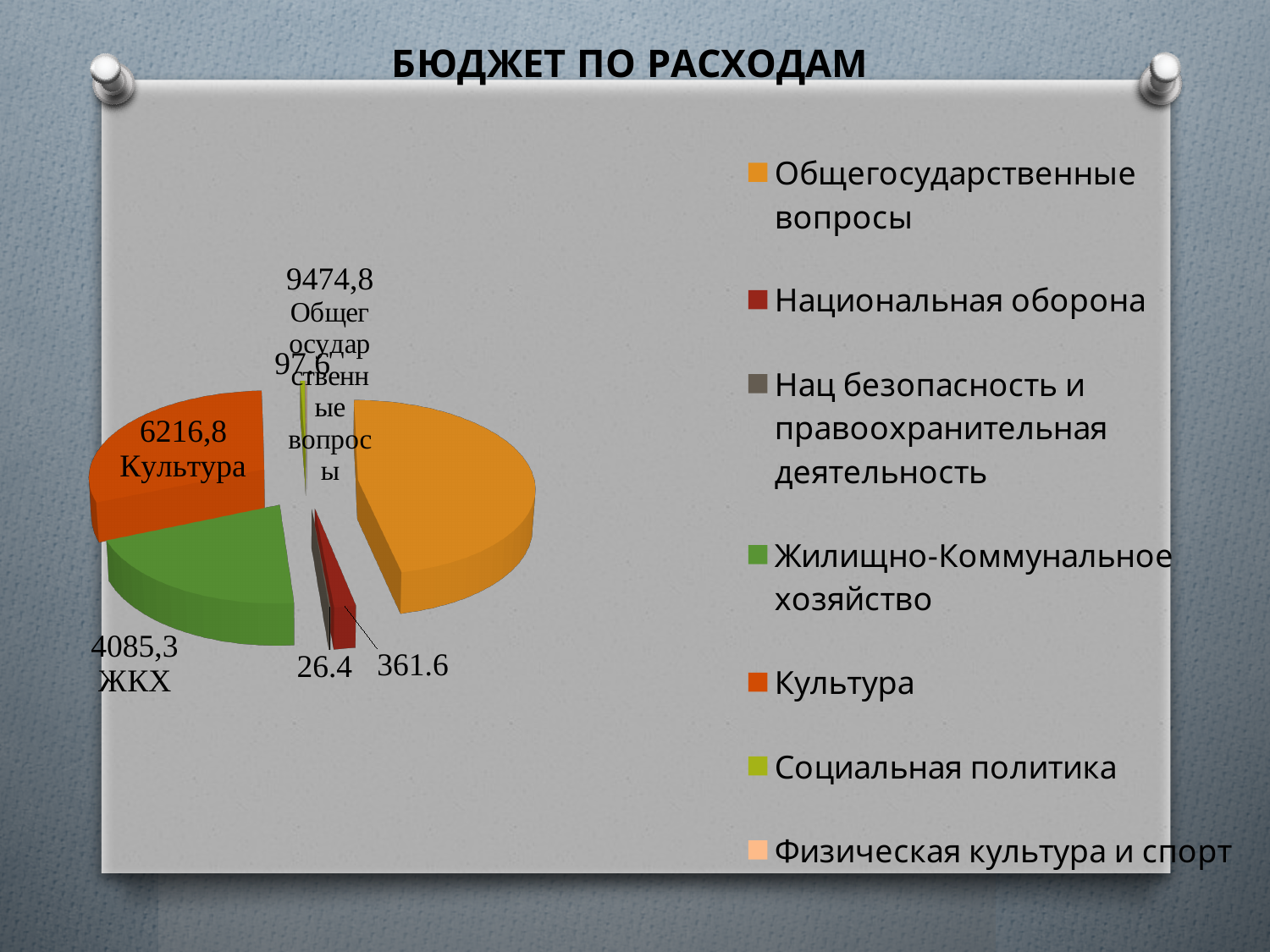
What is the title of the chart? БЮДЖЕТ ПО РАСХОДАМ What is the value for Общегосударственные вопросы? 9474,8 What is the value for ЖКХ? 4085,3 What is the value for Культура? 6216,8 What is the value for Национальная оборона? 361.6 Which is larger, Культура or ЖКХ? Культура How many entries does the legend list? 7 What is the difference between the values for Культура and ЖКХ? 2131,5 Which category has the largest slice of the pie? Общегосударственные вопросы What is the value for Социальная политика? 97,6 What colour is the slice for Жилищно-Коммунальное хозяйство? Green What type of chart is shown on the slide? Pie chart